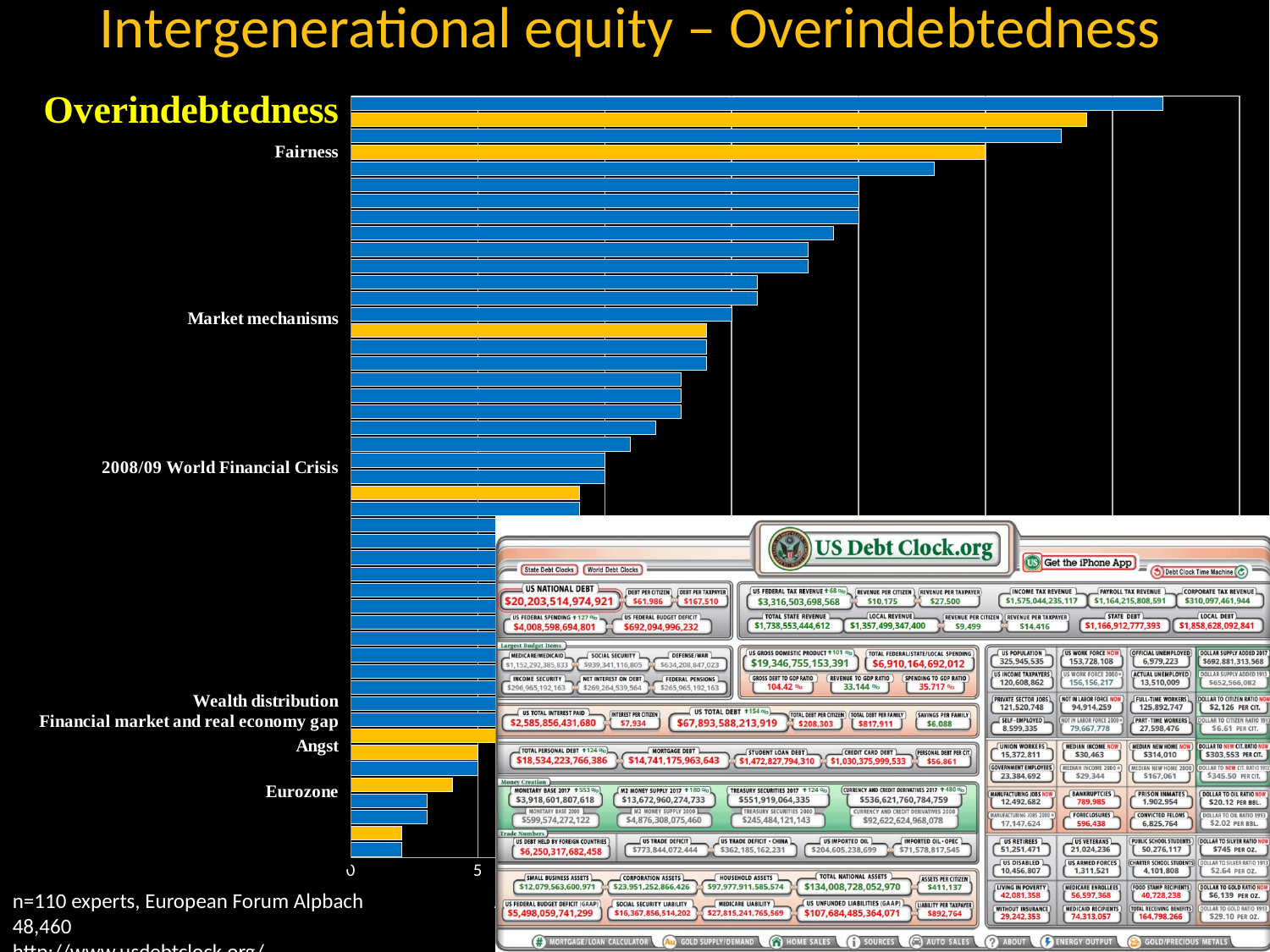
Which has the larger value, Overindebtedness or Eurozone? Overindebtedness Which has the larger value, Fairness or Market mechanisms? Fairness Do the bar lengths increase or decrease going from the top of the chart to the bottom? Decrease What two colours are used for the bars in the chart? Blue and yellow What kind of chart is shown on the slide? Bar chart How many experts does the slide say the data is based on? n=110 experts Is the value for Fairness greater or less than 5? greater Which has the larger value, Market mechanisms or 2008/09 World Financial Crisis? Market mechanisms Among the labeled categories, which has the shortest bar? Eurozone Is the value for Eurozone greater or less than 5? less Is the value for Overindebtedness greater or less than 5? greater